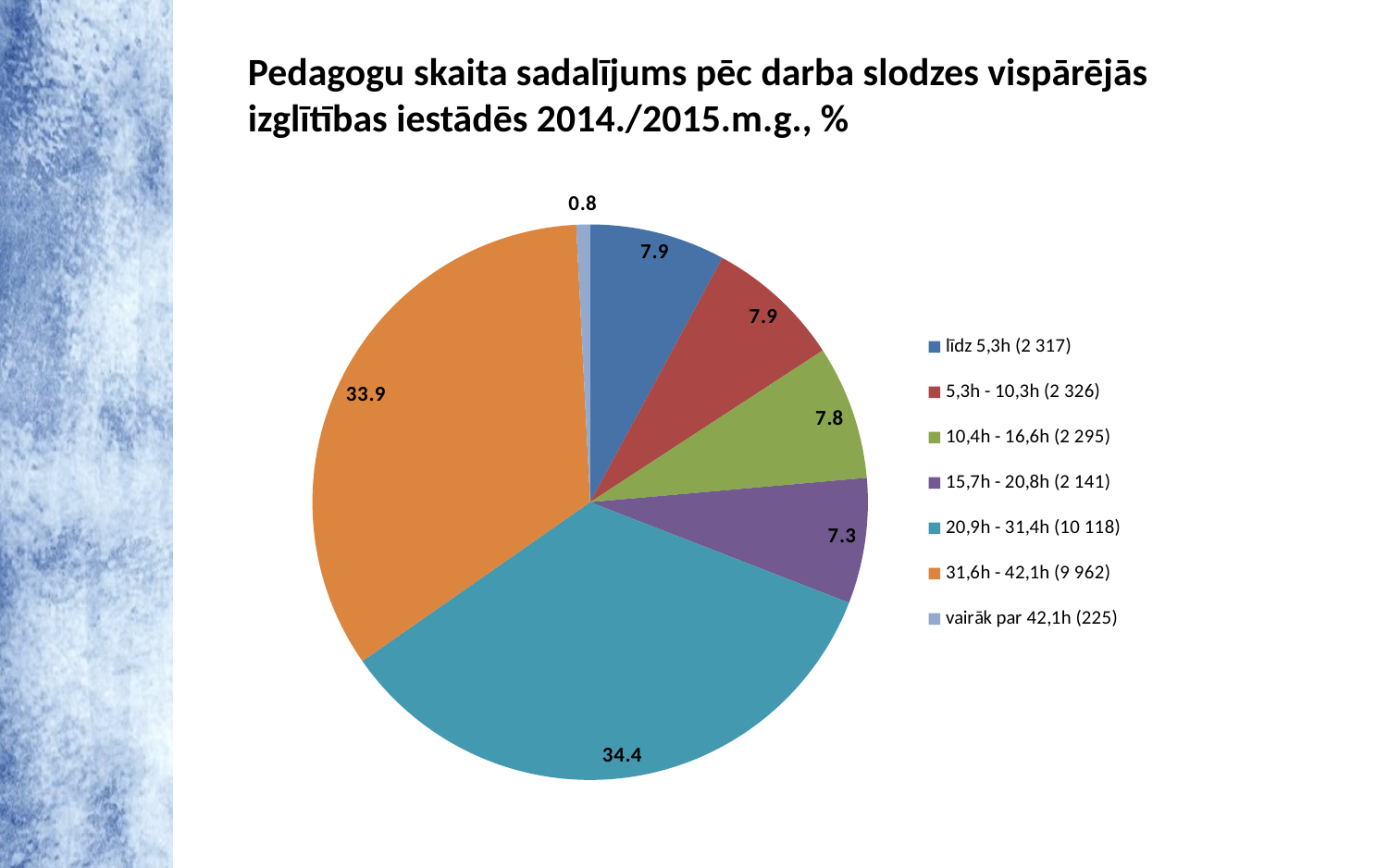
Which is larger, the value for "10,4h - 16,6h" or the value for "15,7h - 20,8h"? 10,4h - 16,6h Which category has the largest slice of the pie? 20,9h - 31,4h (10 118) What share of the pie does the slice "līdz 5,3h (2 317)" represent? 7.9 What is the value shown for the slice "vairāk par 42,1h (225)"? 0.8 Which category has the smallest slice of the pie? vairāk par 42,1h (225) What is the difference between the values for "20,9h - 31,4h" and "31,6h - 42,1h"? 0.5 What is the value shown for the slice "20,9h - 31,4h (10 118)"? 34.4 What kind of chart is shown on the slide? pie chart How many entries does the legend list? 7 What is the value shown for the slice "15,7h - 20,8h (2 141)"? 7.3 How many slices does the pie chart have? 7 What is the value shown for the slice "31,6h - 42,1h (9 962)"? 33.9